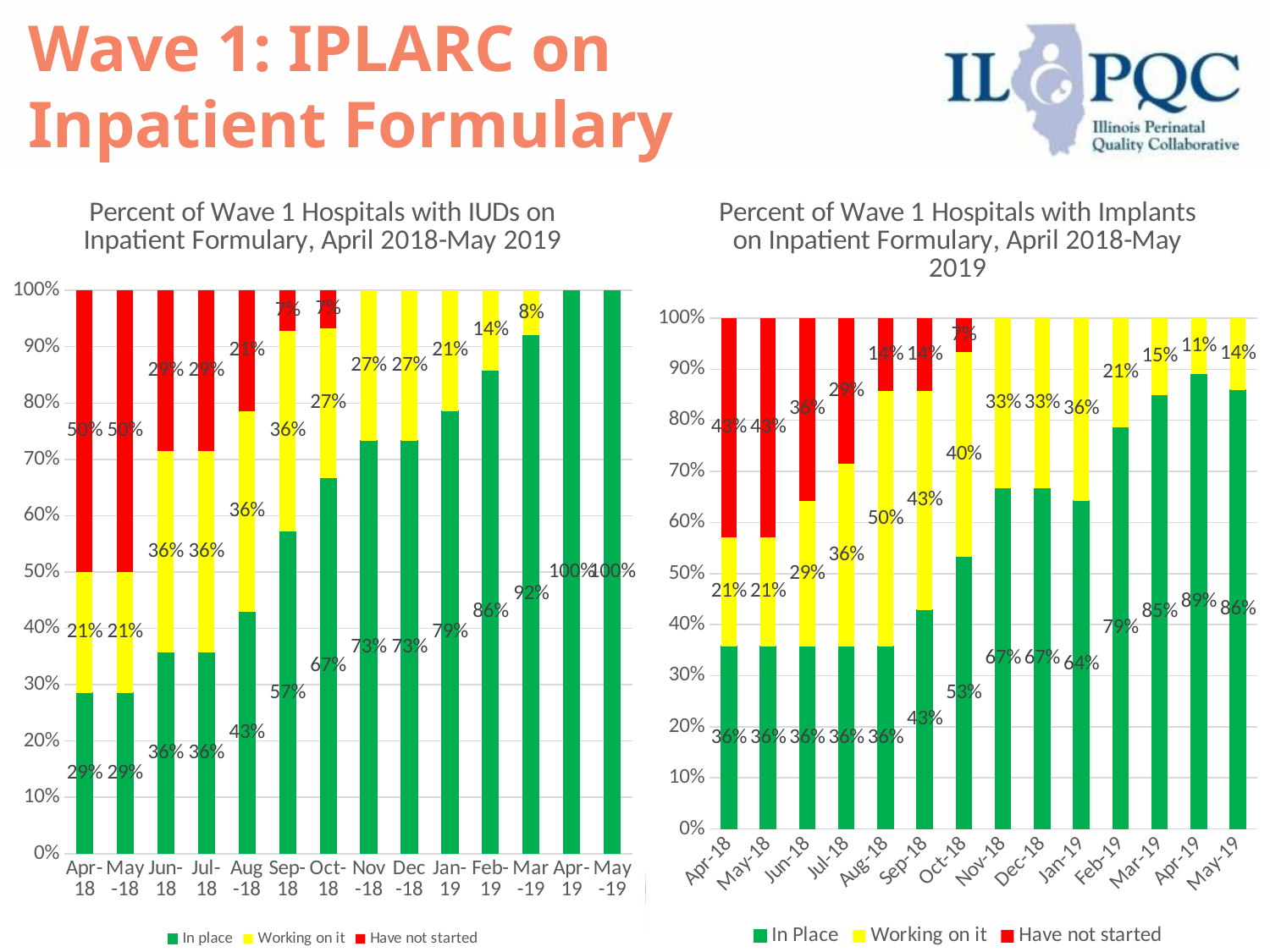
In the chart 'Percent of Wave 1 Hospitals with Implants on Inpatient Formulary', which month has the highest 'In Place' value? Apr-19 In the chart 'Percent of Wave 1 Hospitals with IUDs on Inpatient Formulary', what is the 'Have not started' value for Apr-18? 50% In the chart 'Percent of Wave 1 Hospitals with IUDs on Inpatient Formulary', how much higher is the 'In place' value in Mar-19 than in Feb-19? 6% In the chart 'Percent of Wave 1 Hospitals with Implants on Inpatient Formulary', what is the 'In Place' value for Oct-18? 53% In the chart 'Percent of Wave 1 Hospitals with Implants on Inpatient Formulary', what is the 'Working on it' value for Aug-18? 50% In the chart 'Percent of Wave 1 Hospitals with Implants on Inpatient Formulary', which is larger: the 'In Place' value for Jan-19 or for Dec-18? Dec-18 What type of chart is 'Percent of Wave 1 Hospitals with IUDs on Inpatient Formulary'? stacked bar chart In the chart 'Percent of Wave 1 Hospitals with IUDs on Inpatient Formulary', does the 'In place' series generally rise or fall from Apr-18 to May-19? rise In the chart 'Percent of Wave 1 Hospitals with IUDs on Inpatient Formulary', what is the 'In place' value for Sep-18? 57% How many series does the legend of the chart 'Percent of Wave 1 Hospitals with Implants on Inpatient Formulary' list? 3 In the chart 'Percent of Wave 1 Hospitals with IUDs on Inpatient Formulary', which months have an 'In place' value of 100%? Apr-19 and May-19 In the chart 'Percent of Wave 1 Hospitals with IUDs on Inpatient Formulary', what is the 'Working on it' value for Feb-19? 14%